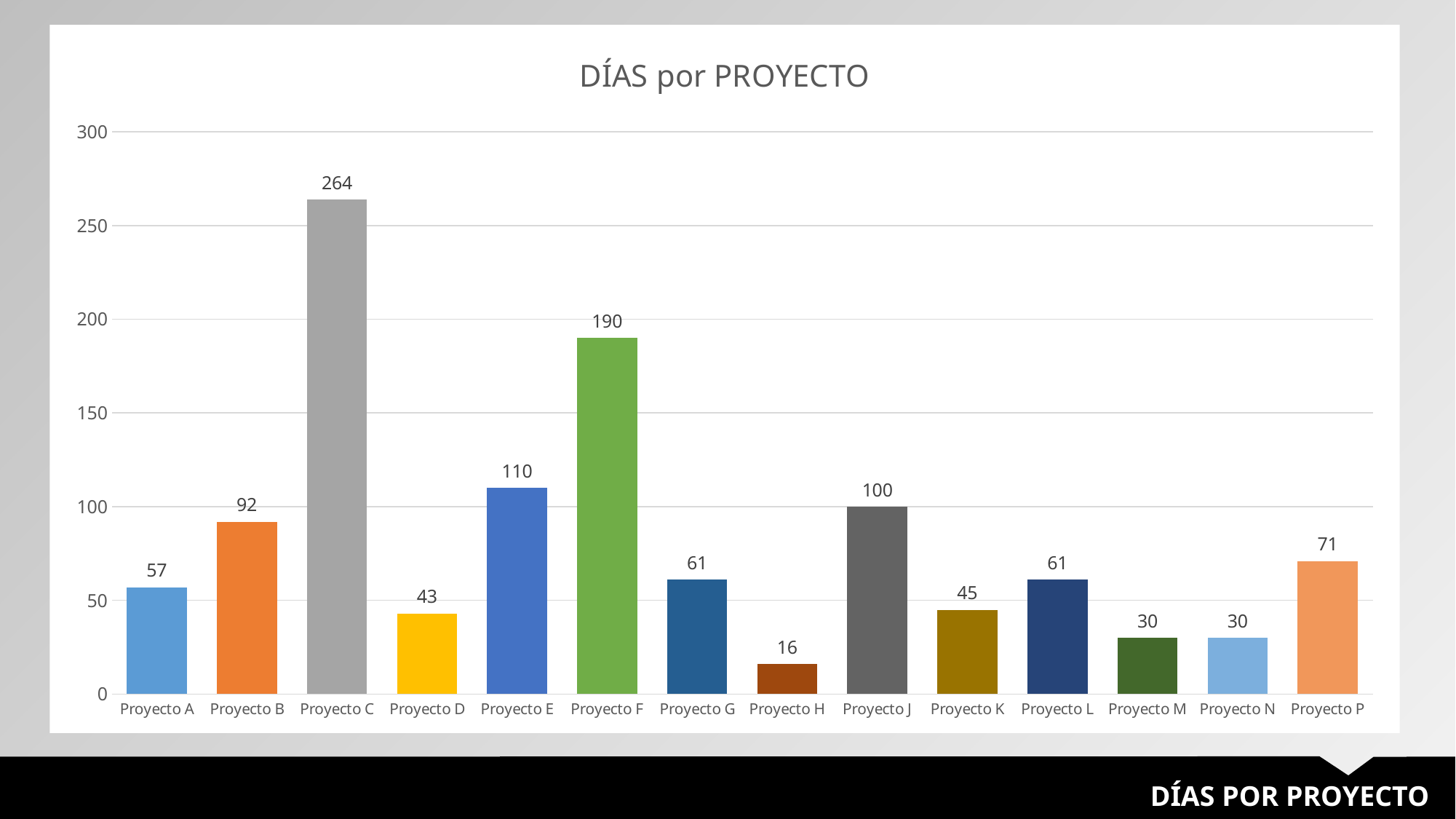
What is the difference between the values for Proyecto C and Proyecto F? 74 Which is larger, the value for Proyecto K or the value for Proyecto P? Proyecto P What is the title of the chart? DÍAS por PROYECTO How many projects are shown on the chart? 14 Which project has the highest value? Proyecto C Is the value for Proyecto F greater or less than 150? greater What kind of chart is shown on the slide? Bar chart What is the value for Proyecto J? 100 What is the difference between the values for Proyecto E and Proyecto B? 18 What is the value for Proyecto H? 16 What is the value for Proyecto C? 264 Which project has the lowest value? Proyecto H